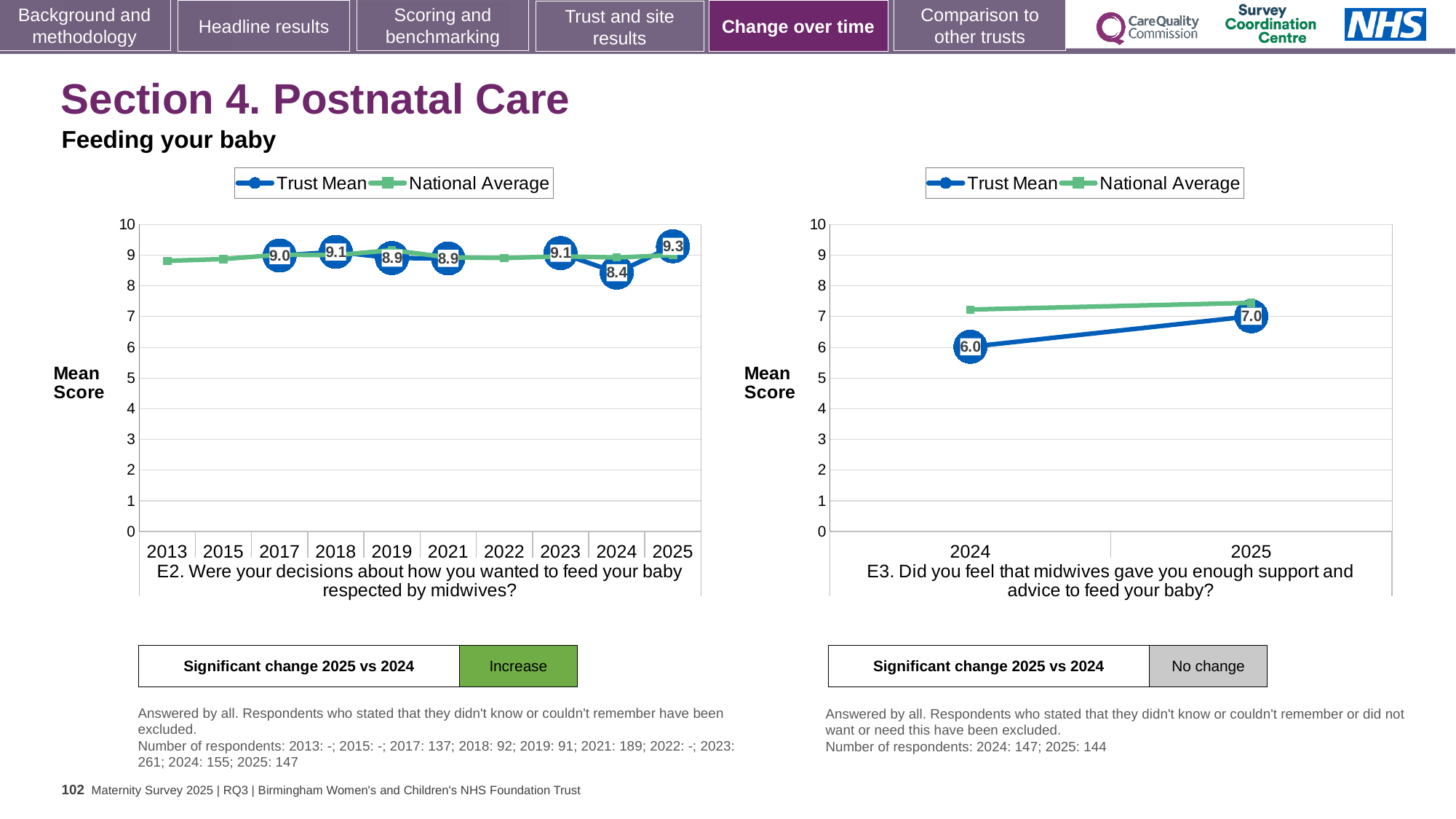
In the E2 chart (left), what is the difference between the Trust Mean in 2025 and in 2024? 0.9 In the E3 chart (right), is the National Average for 2024 greater or less than 7? greater In the E3 chart (right), what is the Trust Mean for 2025? 7.0 In the E3 chart (right), did the Trust Mean rise or fall from 2024 to 2025? rise In the E3 chart (right), what is the Trust Mean for 2024? 6.0 In the E2 chart (left), which year has the highest labelled Trust Mean? 2025 In the E2 chart (left), which year has the lowest labelled Trust Mean? 2024 In the E3 chart (right), which is larger in 2024, the Trust Mean or the National Average? National Average In the E2 chart (left), how many years are shown on the x axis? 10 In the E2 chart (left), what is the Trust Mean for 2025? 9.3 In the E2 chart (left), what is the Trust Mean for 2024? 8.4 How many series does the legend of the E2 chart (left) list? 2